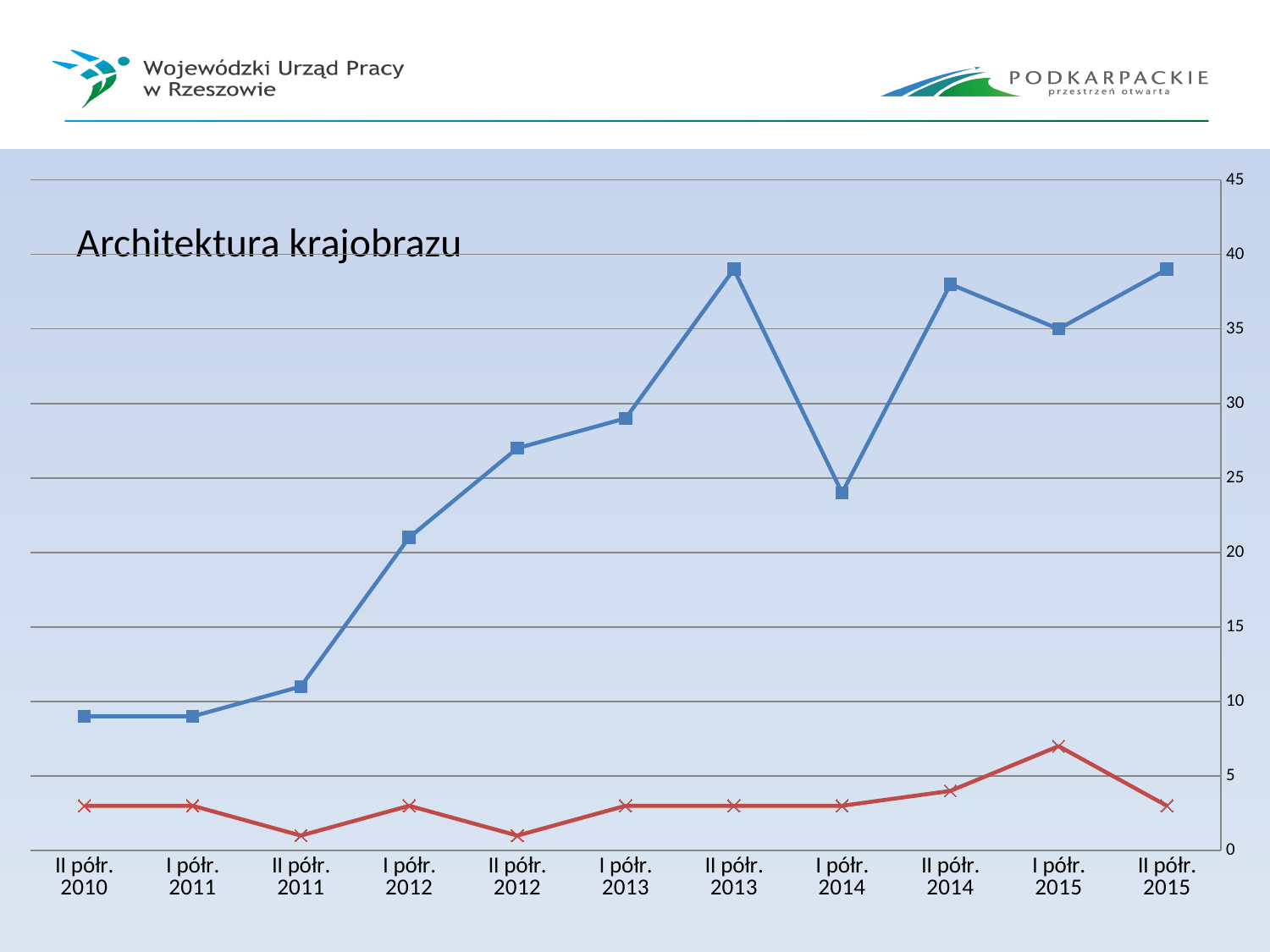
Is the value of the blue line for II półr. 2013 greater or less than 35? greater What kind of chart is shown on the slide? line chart Does the blue line rise or fall between II półr. 2010 and II półr. 2013? rises What is the title of the chart? Architektura krajobrazu In which period does the red line reach its highest value? I półr. 2015 Is the value of the red line for I półr. 2015 greater or less than 5? greater Does the blue line rise or fall between II półr. 2013 and I półr. 2014? falls How many half-year periods are shown on the x axis of the chart? 11 On the blue line, which period has the larger value: II półr. 2013 or I półr. 2014? II półr. 2013 Is the value of the blue line for I półr. 2014 greater or less than 25? less How many lines are plotted on the chart? 2